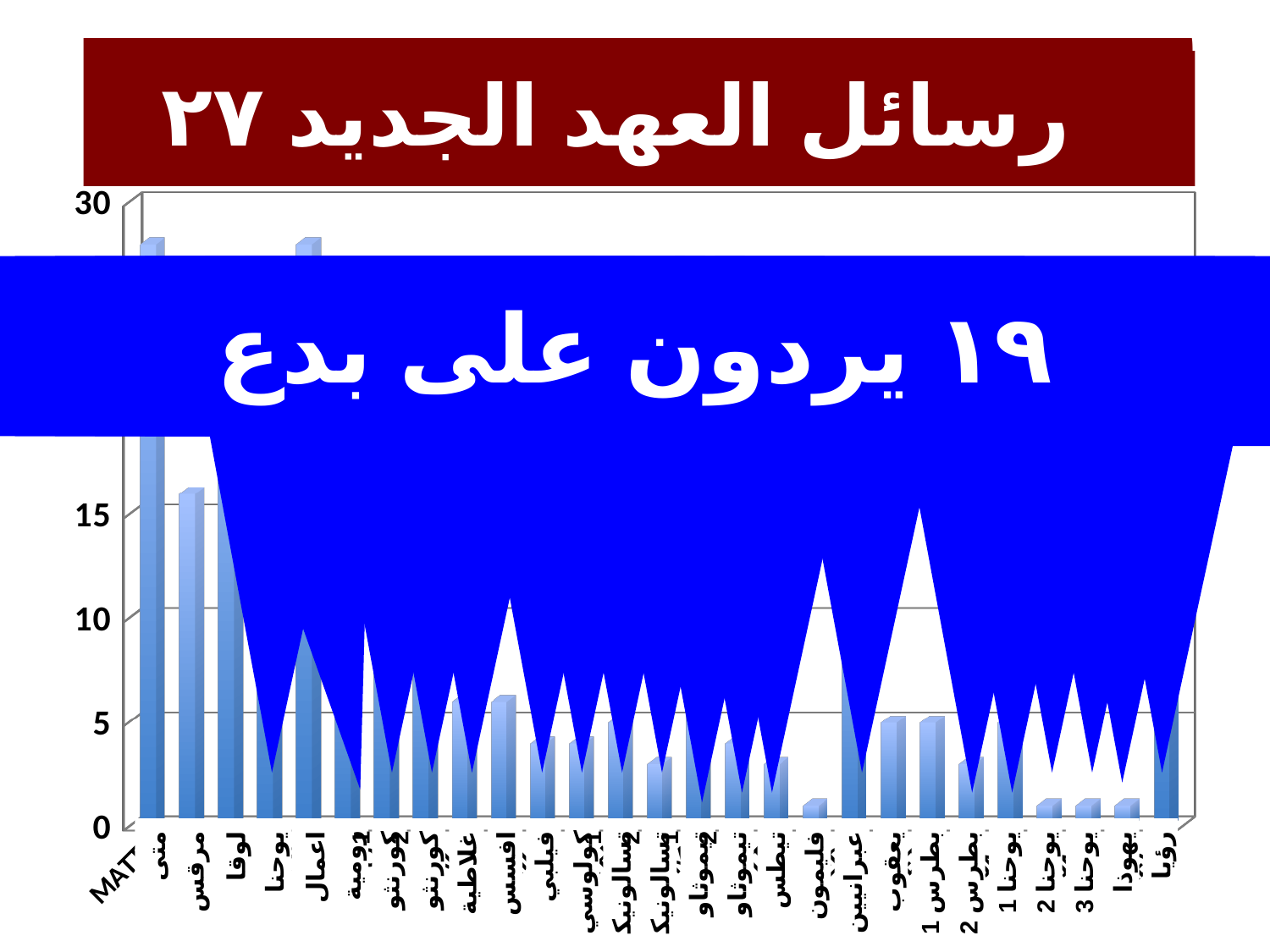
What is the highest value shown on the vertical axis? 30 Is the value for فليمون greater or less than 5? less Is the value for مرقس greater or less than 10? greater What kind of chart is shown on the slide? bar chart Is the value for يهوذا greater or less than 5? less Which has the larger value, مرقس or فليمون? مرقس What text is written on the blue banner overlaying the chart? ١٩ يردون على بدع Which has the larger value, متى or مرقس? متى Which category has the tallest bar in the chart? متى and اعمال What is the title of the slide above the chart? رسائل العهد الجديد ٢٧